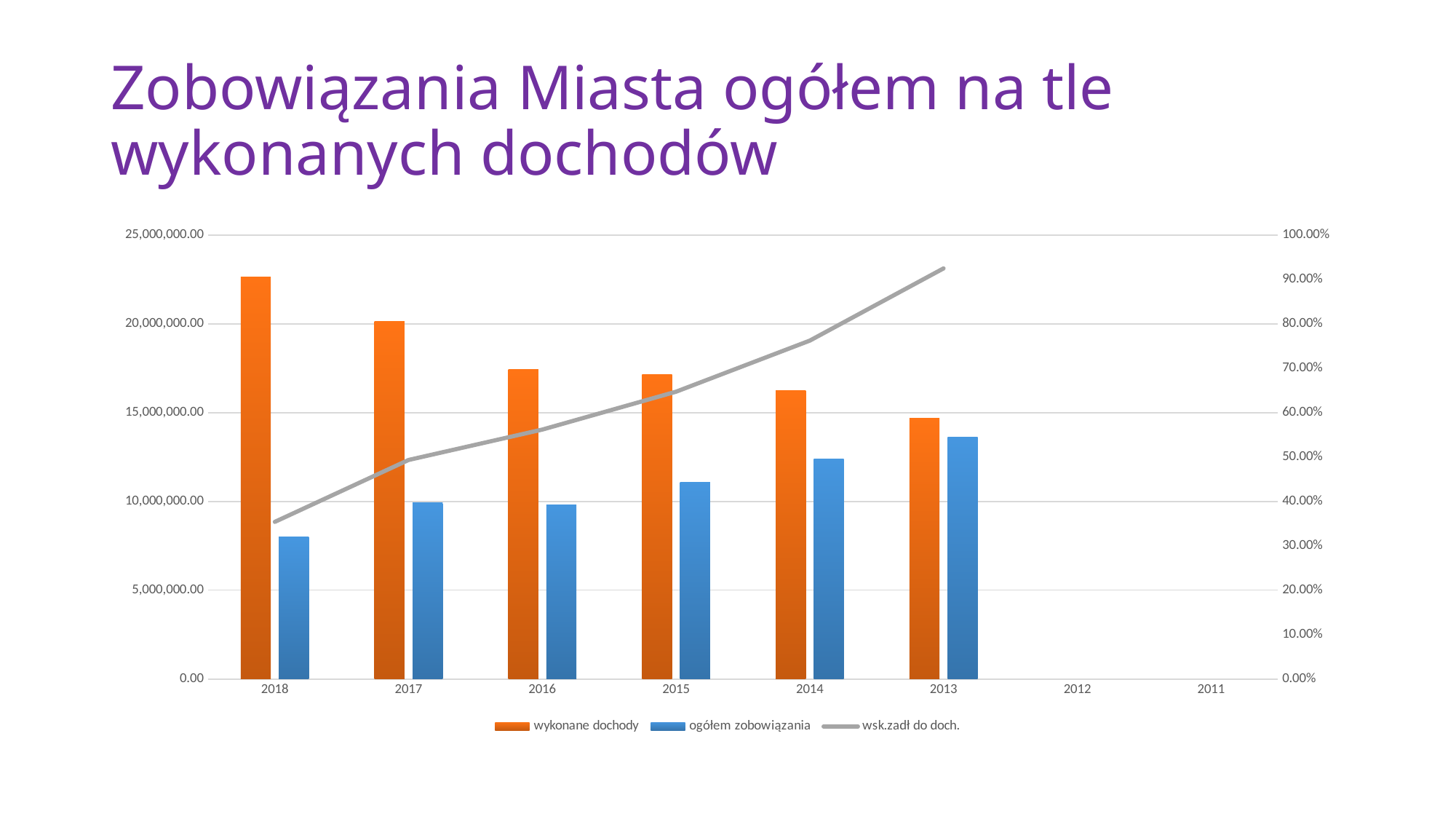
Which is larger in 2014: wykonane dochody or ogółem zobowiązania? wykonane dochody Does the wsk.zadł do doch. line rise or fall moving from 2018 to 2013 along the x axis? rise Is the value for wykonane dochody in 2018 greater or less than 20,000,000.00? greater For how many years are bars plotted in the chart? 6 Is the value for ogółem zobowiązania in 2018 greater or less than 10,000,000.00? less Is the wsk.zadł do doch. value for 2013 greater or less than 90.00%? greater Which year has the highest value for ogółem zobowiązania? 2013 Which year has the lowest value for wykonane dochody among the years with bars? 2013 What kind of chart is shown on the slide? A combination bar and line chart How many series does the legend list? 3 Which year has the lowest value for ogółem zobowiązania? 2018 Which year has the highest value for wykonane dochody? 2018